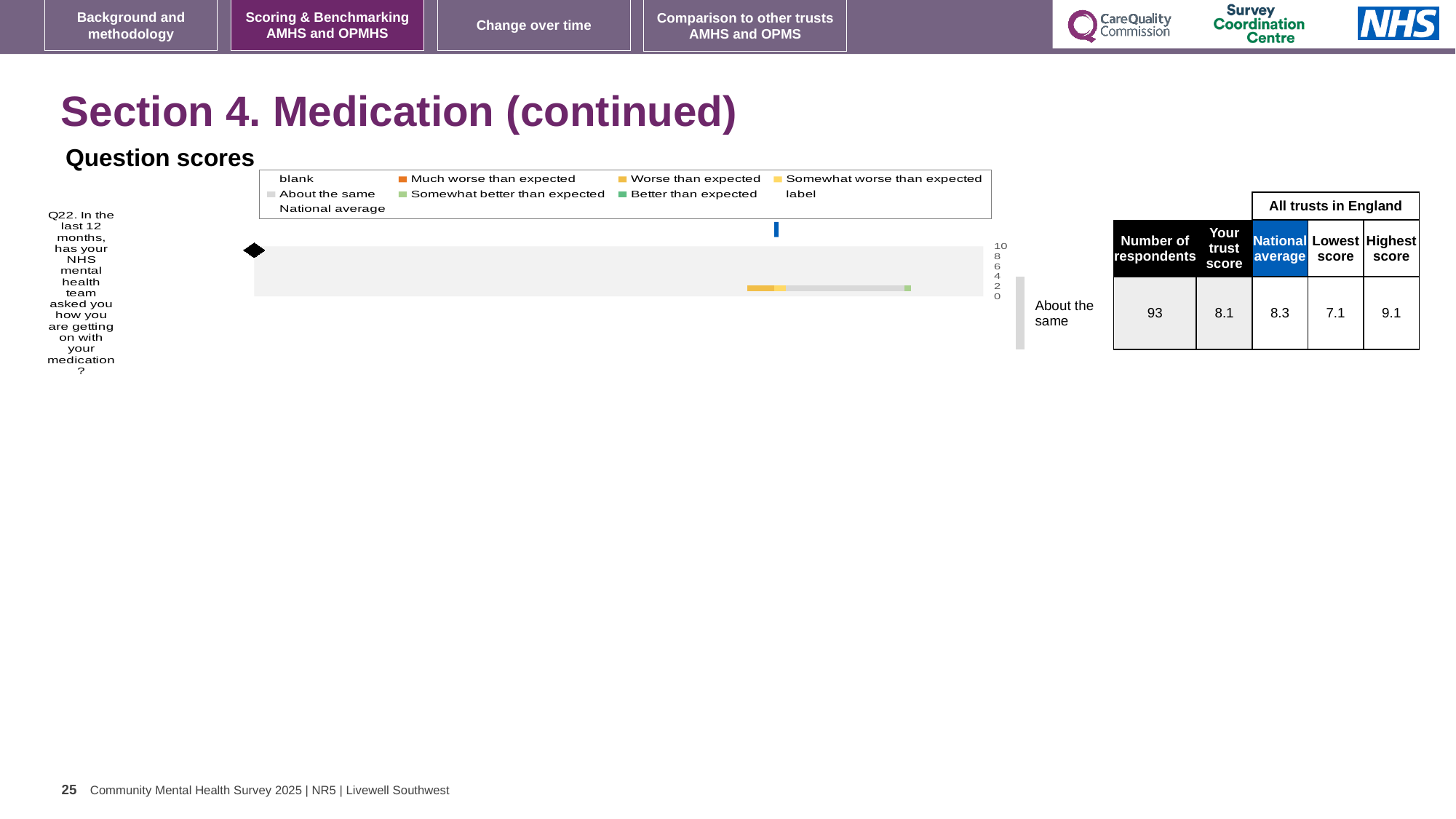
In the chart legend, what colour represents 'Better than expected'? green How many questions are plotted in the Question scores chart? 1 What is the trust score for Q22 shown beside the chart? 8.1 What kind of chart is shown under 'Question scores'? bar chart What is the difference between the highest score and the lowest score for Q22? 2.0 What is the national average for Q22 shown beside the chart? 8.3 In the chart legend, what colour represents 'Much worse than expected'? orange What is the highest score among all trusts in England for Q22? 9.1 Which is larger for Q22, the trust score or the national average? national average What is the number of respondents for Q22 shown beside the chart? 93 Which benchmark category is Q22 assigned to in the Question scores chart? About the same How many entries does the legend of the Question scores chart list? 9